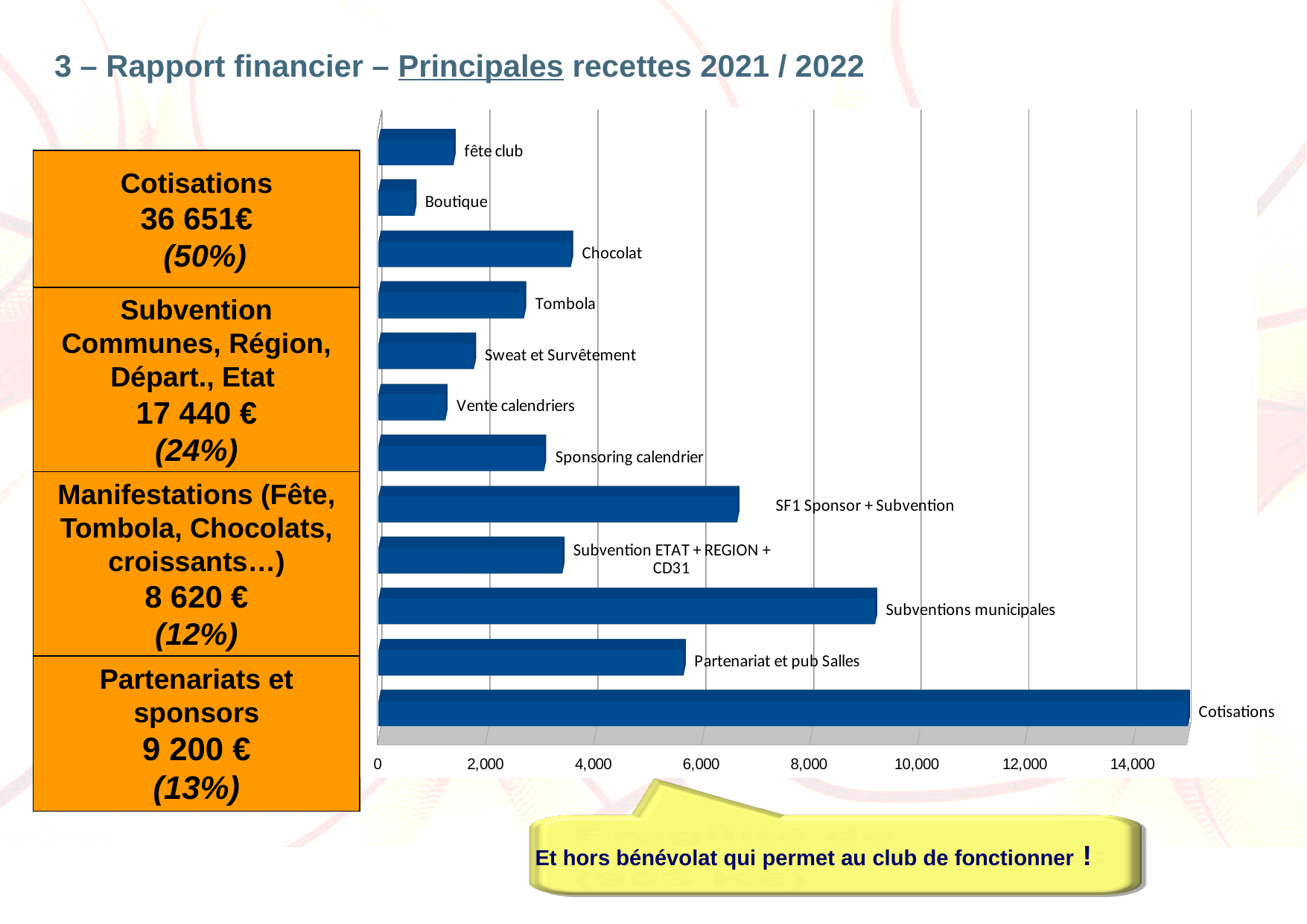
Is the value for Subventions municipales greater or less than 8,000? greater What kind of chart is shown on the slide? bar chart Which is larger, Subventions municipales or SF1 Sponsor + Subvention? Subventions municipales How many categories (bars) does the chart show? 12 Is the value for Partenariat et pub Salles greater or less than 6,000? less Is the value for Boutique greater or less than 2,000? less Which category has the highest value in the chart? Cotisations What colour are the bars in the chart? blue Which is larger, Chocolat or Tombola? Chocolat Which category has the lowest value in the chart? Boutique